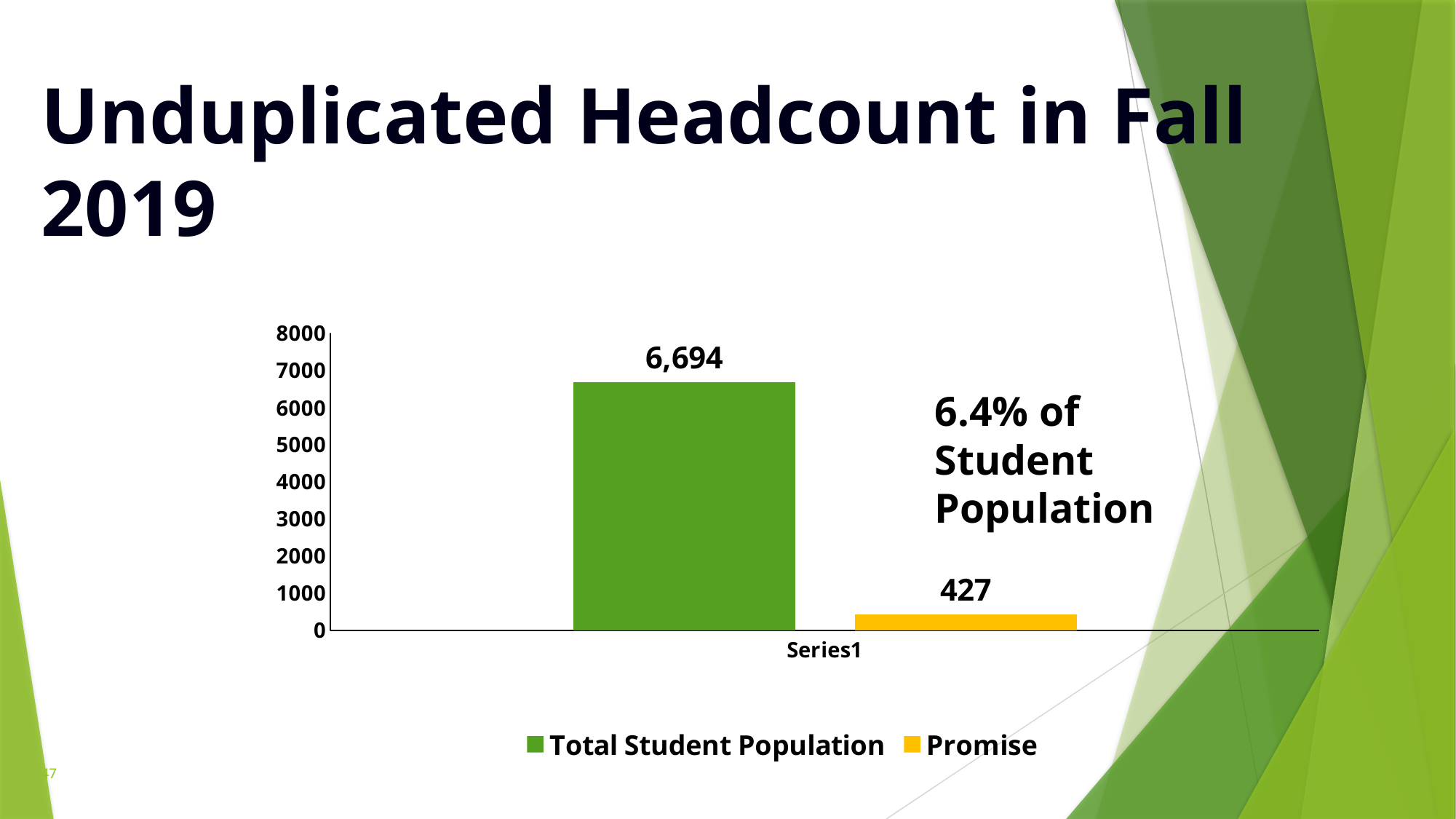
What kind of chart is shown on the slide? bar chart Is the value for Total Student Population greater or less than 6000? greater How many series does the legend list? 2 What is the value for Promise? 427 What percentage of the student population does the text annotation say Promise represents? 6.4% What is the maximum value shown on the vertical axis? 8000 What colour is the Promise bar? yellow Which series has the higher value, Total Student Population or Promise? Total Student Population Which series has the lowest value? Promise Is the value for Promise greater or less than 1000? less What is the difference between the Total Student Population value and the Promise value? 6,267 What is the value for Total Student Population? 6,694